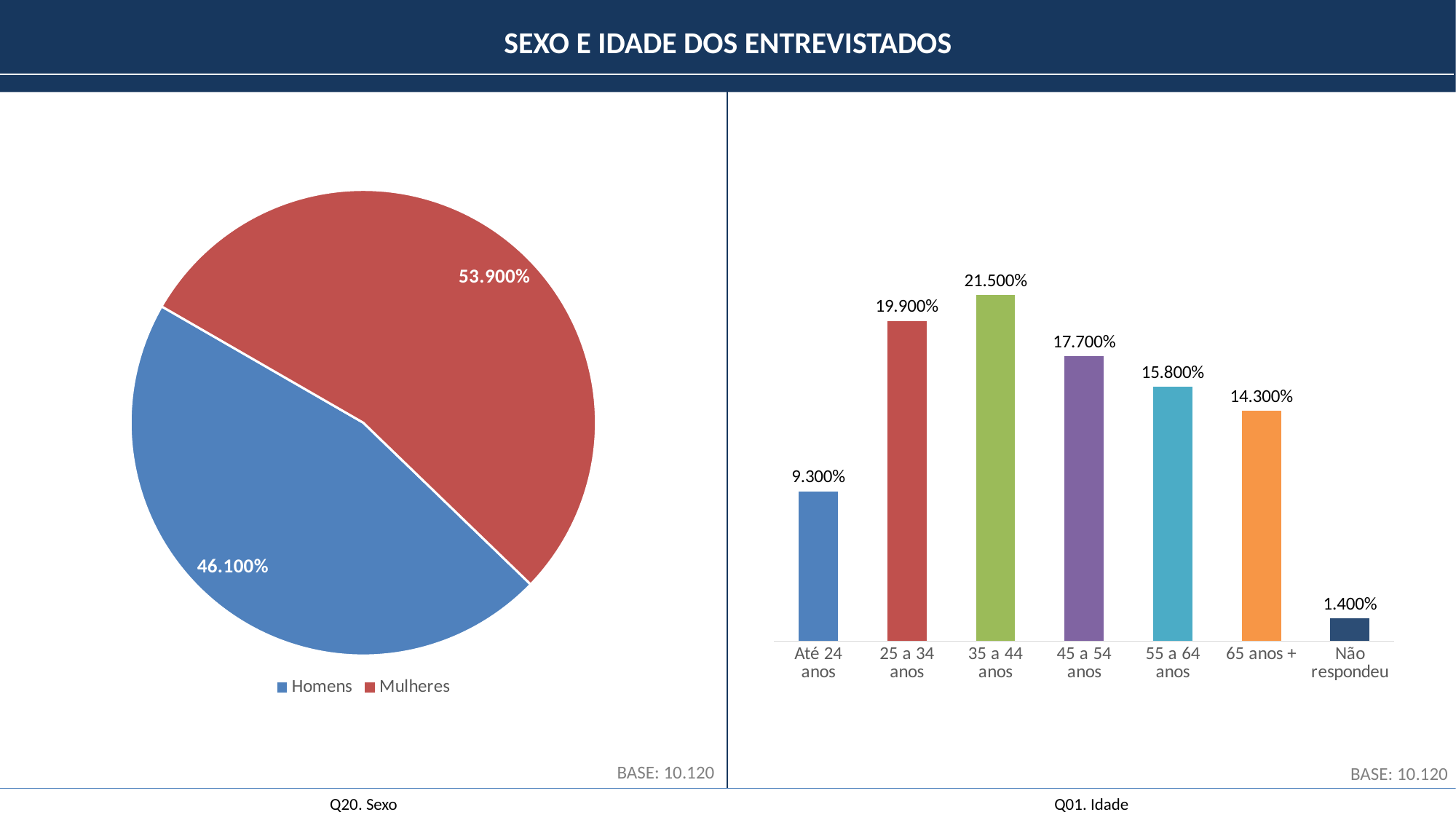
In the pie chart on the left (Q20. Sexo), what share is shown for Mulheres? 53.900% In the pie chart on the left (Q20. Sexo), which group has the larger share, Homens or Mulheres? Mulheres In the pie chart on the left (Q20. Sexo), what is the difference between the Mulheres and Homens shares? 7.800% In the bar chart on the right (Q01. Idade), what is the value for Não respondeu? 1.400% In the bar chart on the right (Q01. Idade), which age category has the highest value? 35 a 44 anos In the bar chart on the right (Q01. Idade), what is the difference between the values for 25 a 34 anos and Até 24 anos? 10.600% In the pie chart on the left (Q20. Sexo), what share is shown for Homens? 46.100% In the bar chart on the right (Q01. Idade), how many categories are shown on the x axis? 7 What type of chart is shown on the left side of the slide (Q20. Sexo)? Pie chart In the pie chart on the left (Q20. Sexo), how many entries does the legend list? 2 In the bar chart on the right (Q01. Idade), which category has the lowest value? Não respondeu In the bar chart on the right (Q01. Idade), what is the value for 35 a 44 anos? 21.500%